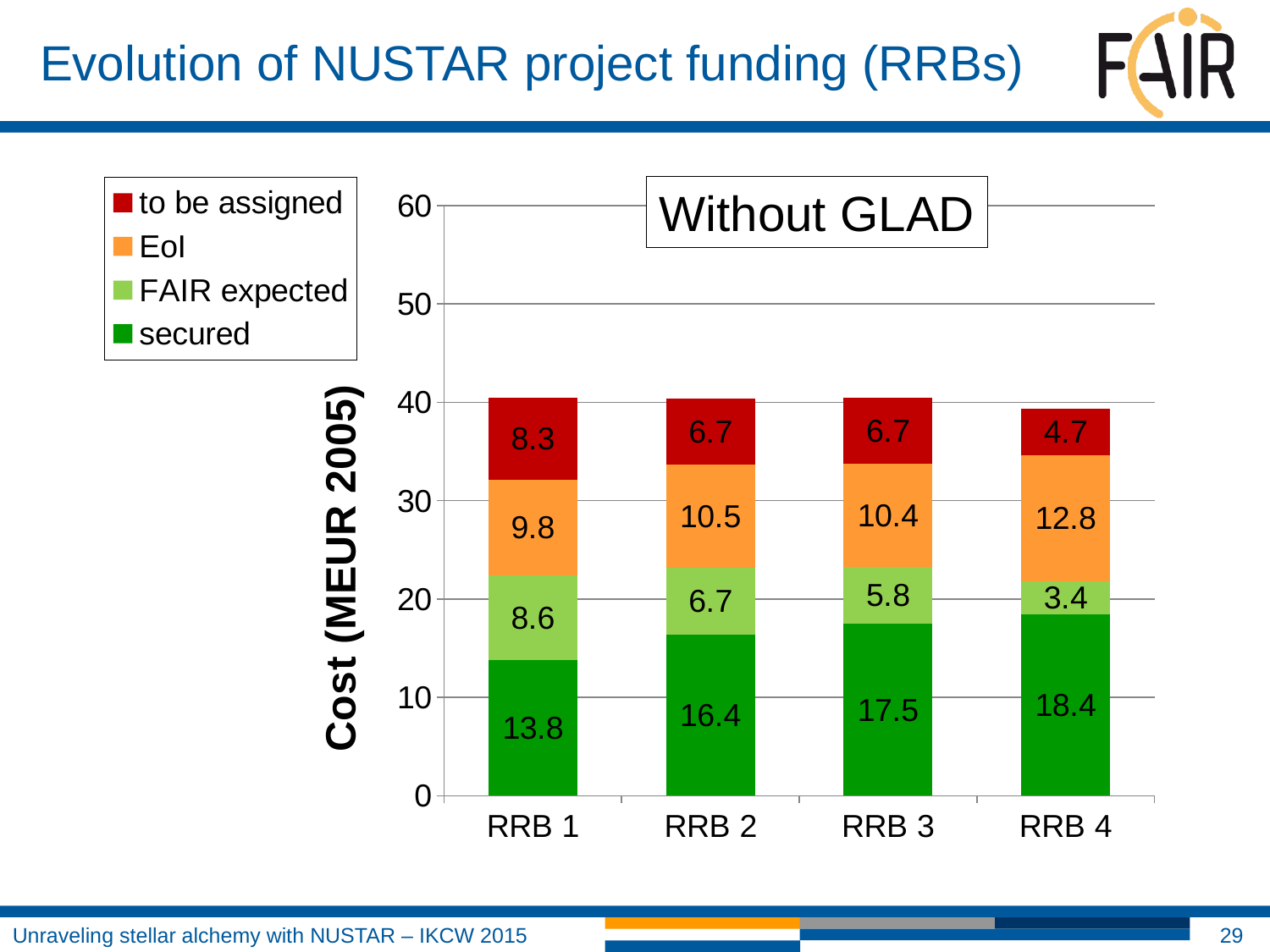
What is the EoI value for RRB 4? 12.8 What is the difference between the secured value for RRB 4 and the secured value for RRB 1? 4.6 What is the total of the stacked bar for RRB 1? 40.5 How many series does the legend list? 4 Which is larger, the EoI value for RRB 2 or the EoI value for RRB 3? RRB 2 What is the secured value for RRB 1? 13.8 Which RRB has the highest secured value? RRB 4 Which RRB has the lowest FAIR expected value? RRB 4 What kind of chart is shown on the slide? Stacked bar chart Does the secured value rise or fall from RRB 1 to RRB 4? Rise What is the 'to be assigned' value for RRB 2? 6.7 How many RRB categories are shown on the x axis? 4